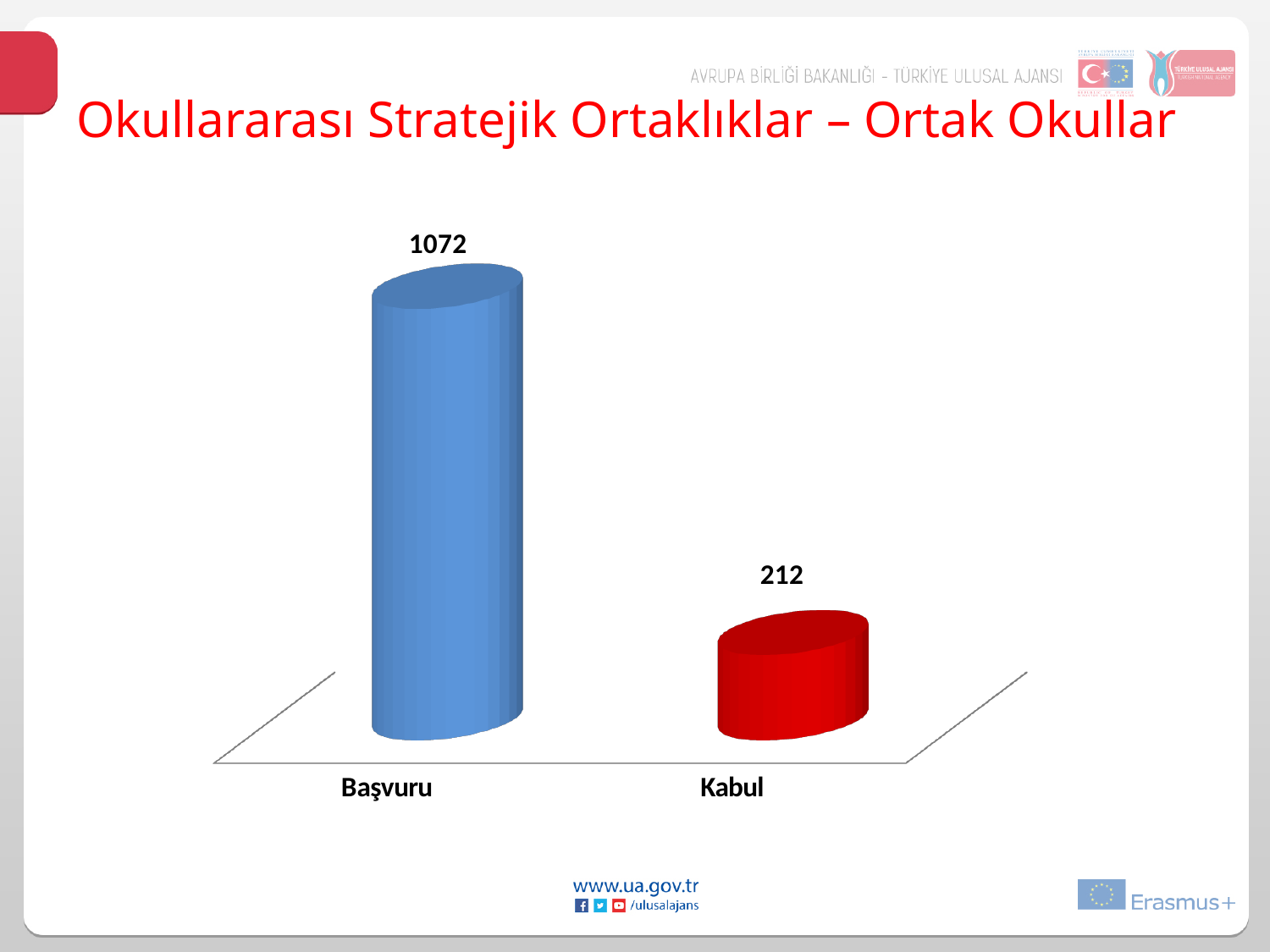
Which is larger, the value for Başvuru or the value for Kabul? Başvuru What is the total of the two values shown in the chart? 1284 How many categories are shown in the chart? 2 What colour is the bar for Kabul? Red What is the value for Kabul? 212 Which category has the highest value? Başvuru What is the title of the slide containing the chart? Okullararası Stratejik Ortaklıklar – Ortak Okullar Which category has the lowest value? Kabul What kind of chart is shown on the slide? Bar chart What is the value for Başvuru? 1072 What is the difference between the values for Başvuru and Kabul? 860 Do the values rise or fall from Başvuru to Kabul? Fall